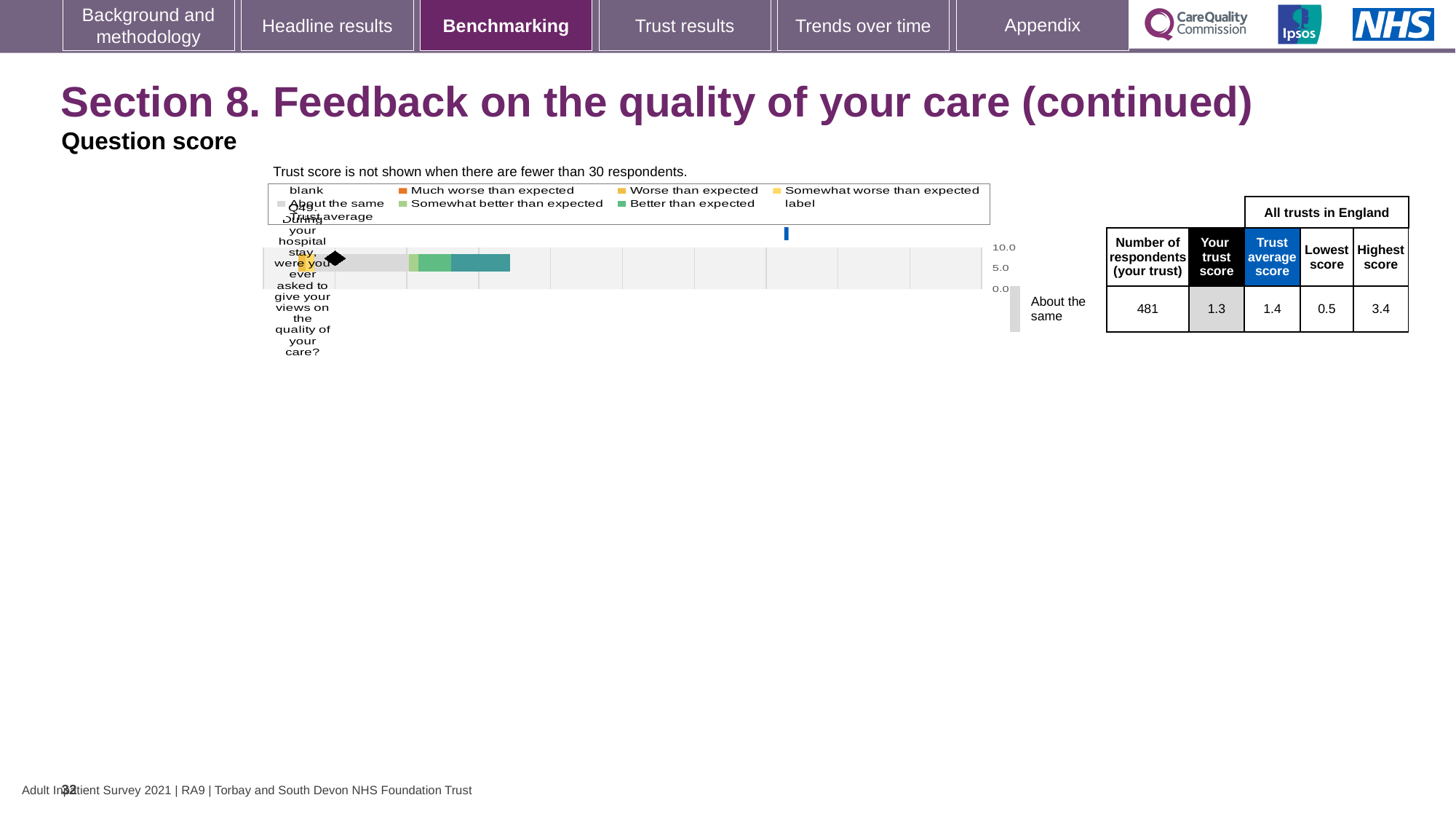
In the table beside the chart, what is the number of respondents for your trust? 481 In the table beside the chart, what is the highest score among all trusts in England? 3.4 Is the trust score marker for Q49 greater or less than 5.0 on the axis? less What kind of chart is shown on the slide? bar chart In the table beside the chart, what is the lowest score among all trusts in England? 0.5 What benchmark category label is shown to the right of the chart for Q49? About the same What is the difference between the highest score and the lowest score for all trusts in England for Q49? 2.9 In the table beside the chart, what is your trust score for Q49? 1.3 Which is larger for Q49: your trust score or the trust average score? trust average score What is the highest value shown on the chart's axis? 10.0 In the table beside the chart, what is the trust average score for Q49? 1.4 How many questions (categories) are plotted in the chart? 1